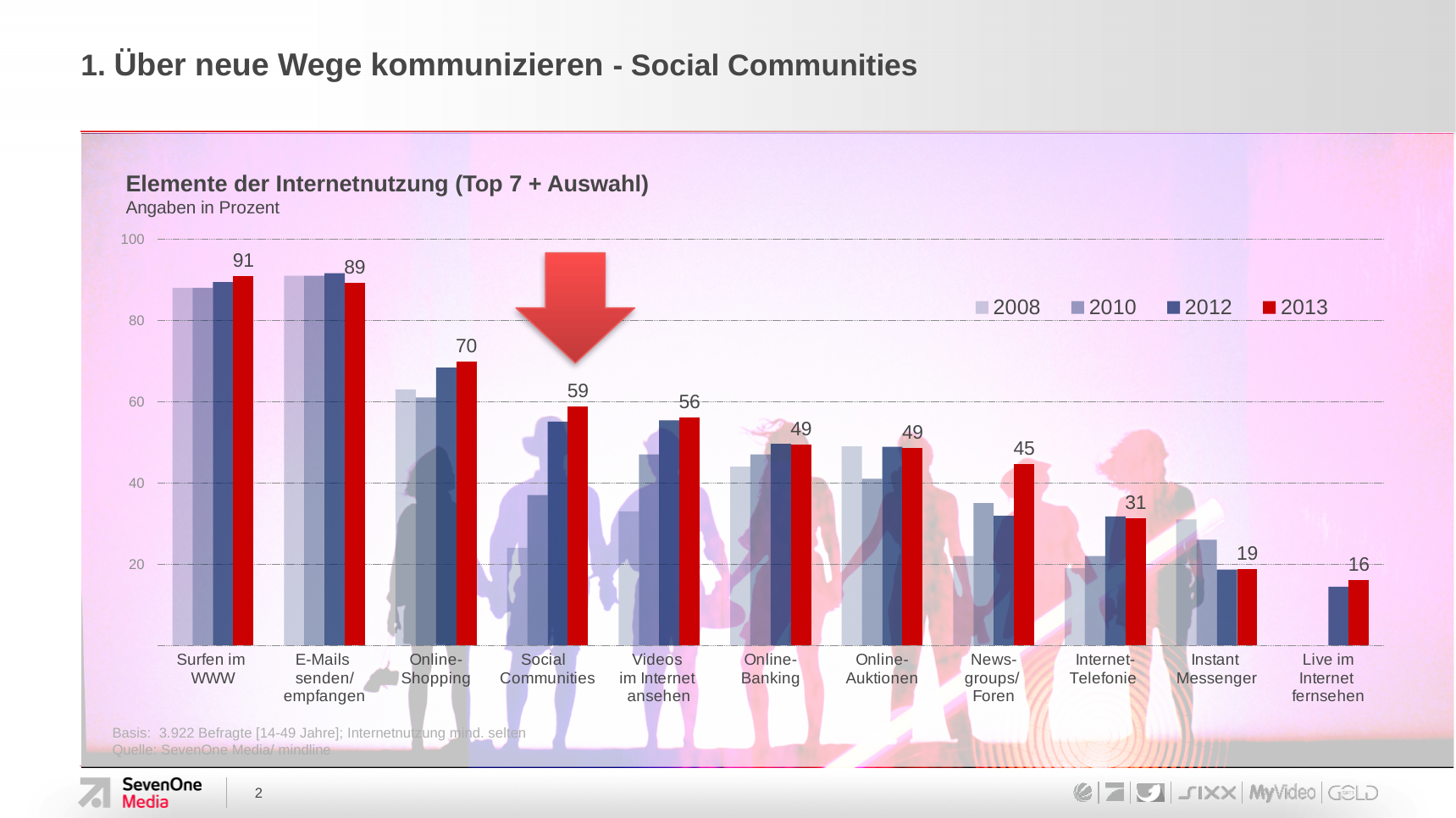
Which category has the highest 2013 value? Surfen im WWW How many series does the legend list? 4 Is the 2008 value for Social Communities greater or less than 40? less Is the 2008 value for Online-Shopping greater or less than 60? greater Which category has the lowest 2013 value? Live im Internet fernsehen How many categories are shown on the x axis? 11 What is the difference between the 2013 values for Surfen im WWW and E-Mails senden/empfangen? 2 What kind of chart is shown on the slide? Bar chart What is the 2013 value for Instant Messenger? 19 Which has the larger 2013 value, Online-Shopping or Videos im Internet ansehen? Online-Shopping What is the 2013 value for Social Communities? 59 What is the 2013 value for Online-Shopping? 70